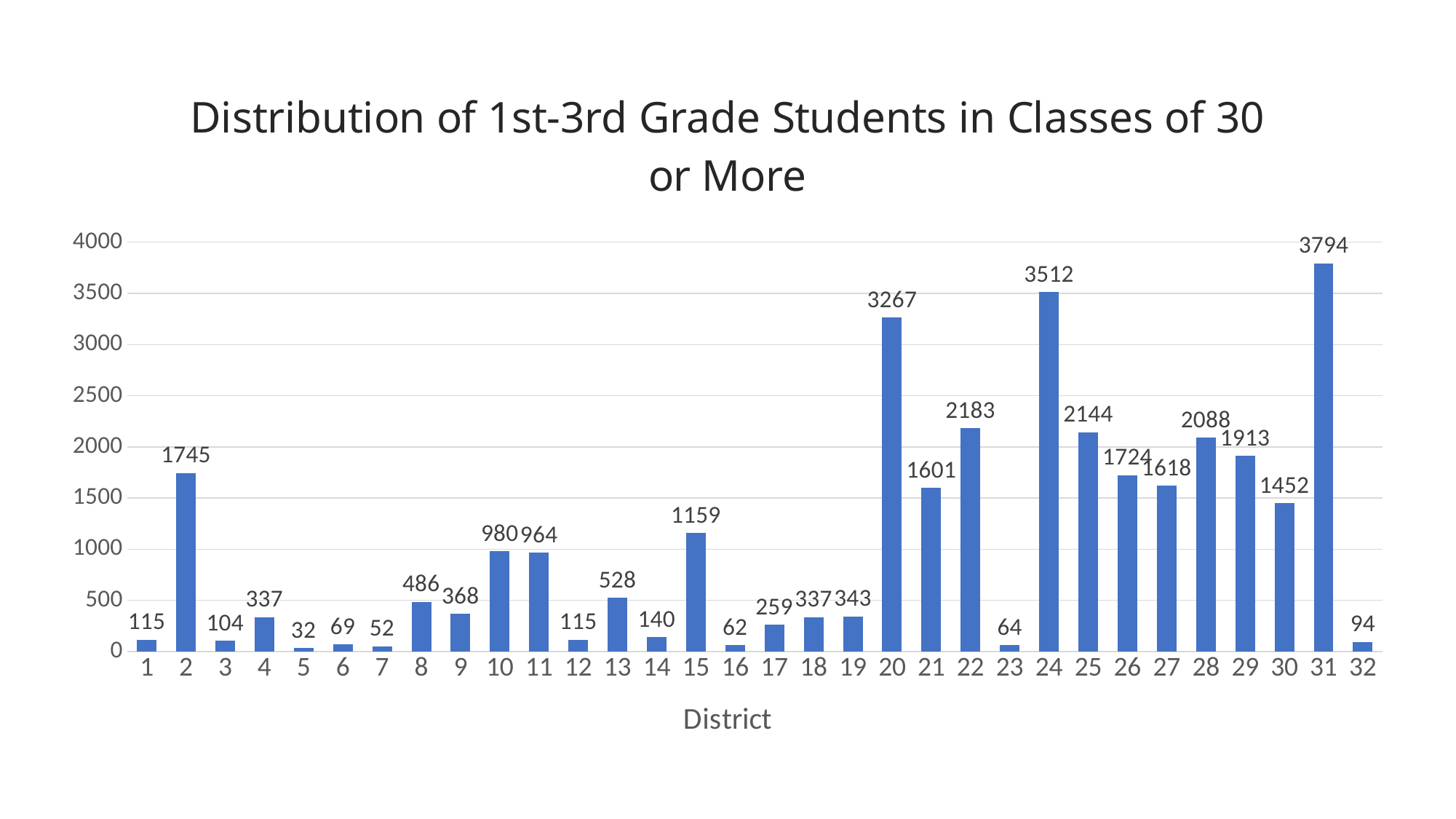
What is the value for district 30? 1452 What is the title of the chart? Distribution of 1st-3rd Grade Students in Classes of 30 or More What kind of chart is this? bar chart What is the difference between the values for district 2 and district 21? 144 Which district has the highest value? 31 What is the value for district 20? 3267 How many districts are shown on the x axis? 32 Is the value for district 15 greater or less than 1000? greater Which district has the lowest value? 5 What is the value for district 8? 486 What is the difference between the values for district 24 and district 20? 245 Which is larger, the value for district 22 or district 25? district 22